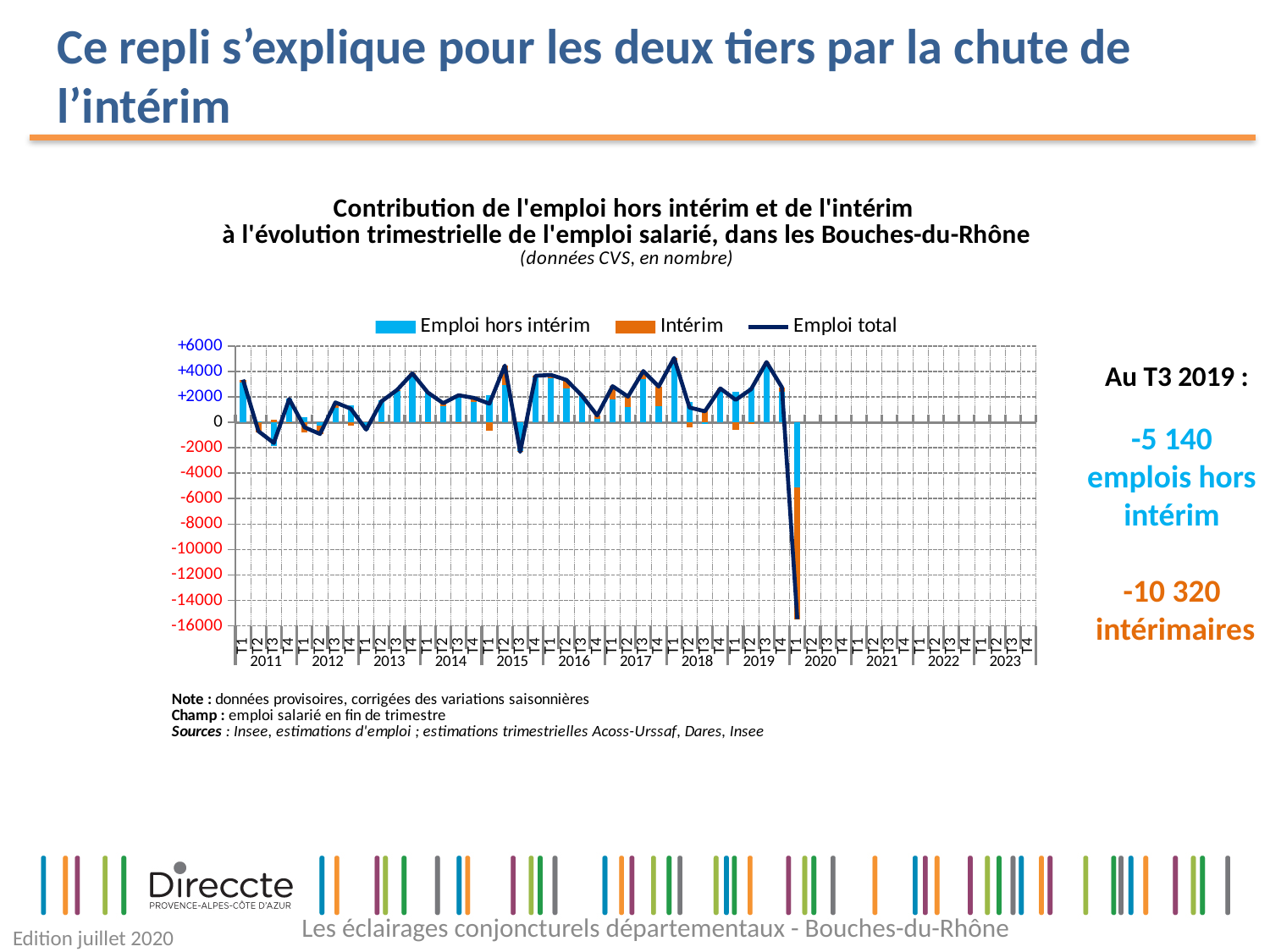
Using the annotated values (-5 140 and -10 320), what is the difference in magnitude between the intérim and hors intérim contributions? 5 180 Does the 'Emploi total' line rise or fall sharply at the last plotted quarter? fall Is the 'Emploi hors intérim' bar at T1 2020 greater or less than -4000? less What kind of chart is shown on the slide? A bar chart combined with a line How many years are labelled along the x axis of the chart? 13 Is the value of the 'Emploi total' line at its final point (T1 2020) greater or less than -14000? less How many series does the chart legend list? 3 What are the three series named in the chart legend? Emploi hors intérim, Intérim, Emploi total Using the annotated values, which contribution is larger in magnitude: emplois hors intérim or intérimaires? intérimaires According to the annotation on the right of the chart, what is the value for 'intérimaires' at T3 2019? -10 320 Which series is drawn as a line rather than bars? Emploi total According to the annotation on the right of the chart, what is the value for 'emplois hors intérim' at T3 2019? -5 140